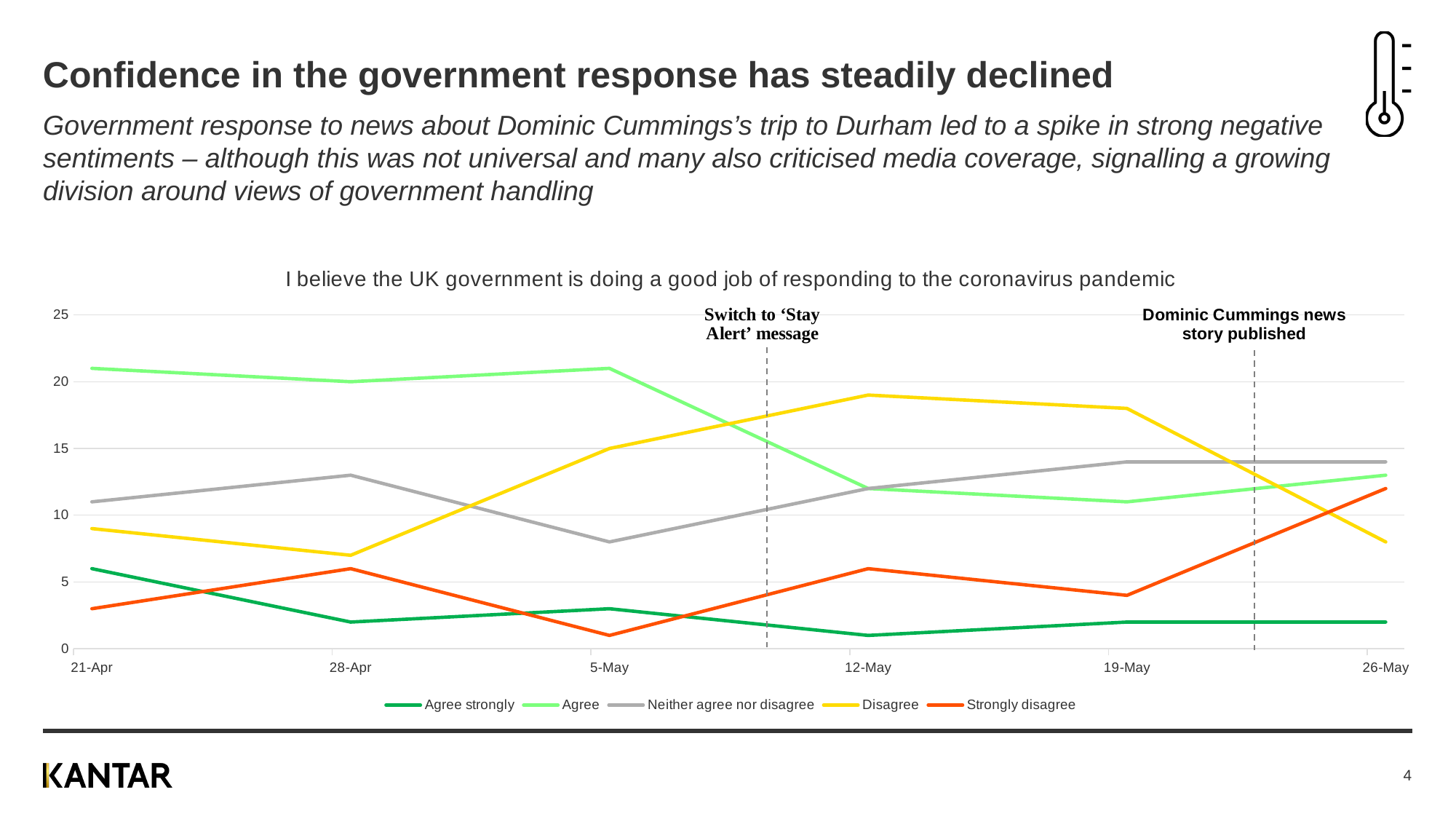
How many series does the legend list? 5 Is the value for Strongly disagree on 26-May greater or less than 10? greater Is the value for Neither agree nor disagree on 5-May greater or less than 10? less How many dates are shown on the x axis? 6 What is the value for Disagree on 5-May? 15 Which series has the lowest value on 26-May? Agree strongly Is the value for Disagree on 12-May greater or less than 15? greater What is the value for Agree on 28-Apr? 20 On 26-May, which is larger: Disagree or Strongly disagree? Strongly disagree What kind of chart is shown on the slide? line chart Which series has the highest value on 12-May? Disagree What is the title of the chart? I believe the UK government is doing a good job of responding to the coronavirus pandemic